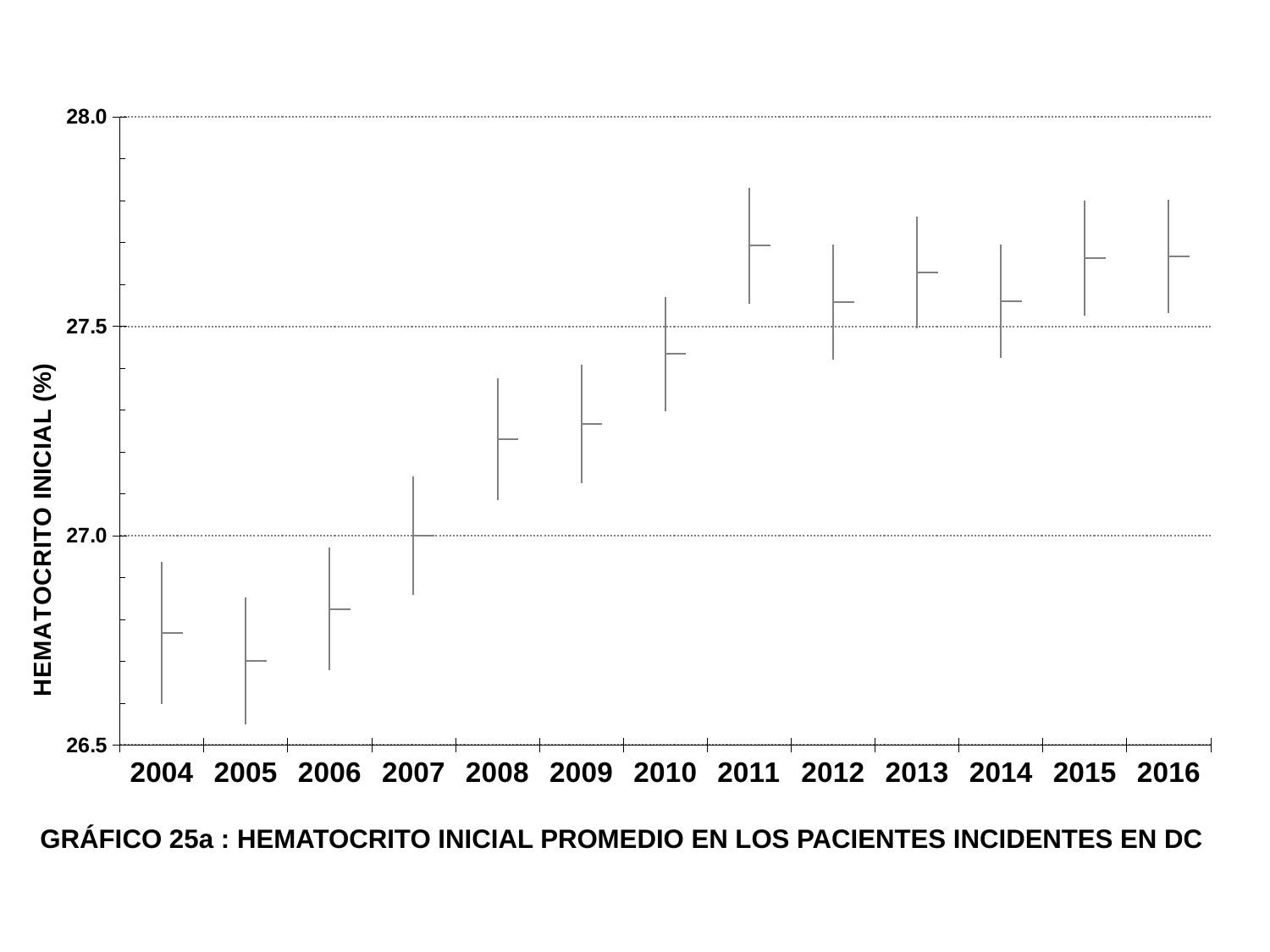
Is the value for 2013 greater or less than 27.5? greater Which is larger, the value for 2010 or the value for 2008? 2010 Is the value for 2008 greater or less than 27.0? greater Do the values generally rise or fall from 2004 to 2016? rise What is the title of the chart? GRÁFICO 25a : HEMATOCRITO INICIAL PROMEDIO EN LOS PACIENTES INCIDENTES EN DC Is the value for 2011 greater or less than 27.5? greater How many years are shown on the x axis of the chart? 13 Which is larger, the value for 2011 or the value for 2004? 2011 What is the label of the y axis? HEMATOCRITO INICIAL (%)